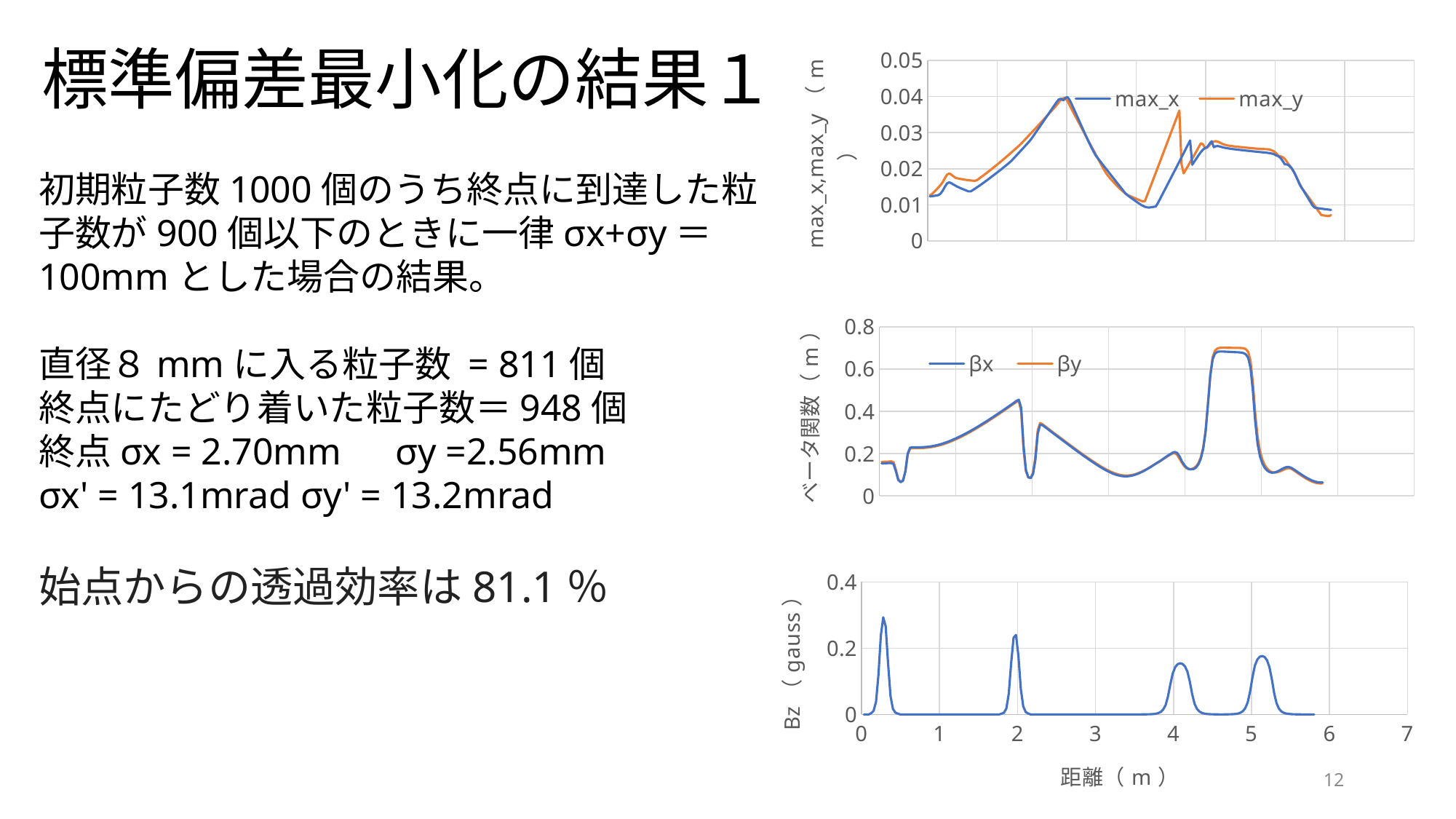
In the middle chart (βx, βy), is the highest value of βx greater or less than 0.6? greater How many series does the legend of the middle chart (βx, βy) list? 2 In the bottom chart (Bz), is the value of the first peak near 0.3 m greater or less than 0.2? greater In the bottom chart (Bz), how many peaks does the curve show? 4 In the top chart (max_x, max_y), which colour is used for the max_y series? orange What is the y-axis label of the middle chart (βx, βy)? ベータ関数（m） What kind of chart is the middle chart (βx, βy)? line chart In the top chart (max_x, max_y), is the value of max_x at 6 m greater or less than 0.02? less What kind of chart is the top chart (max_x, max_y)? line chart How many series does the legend of the top chart (max_x, max_y) list? 2